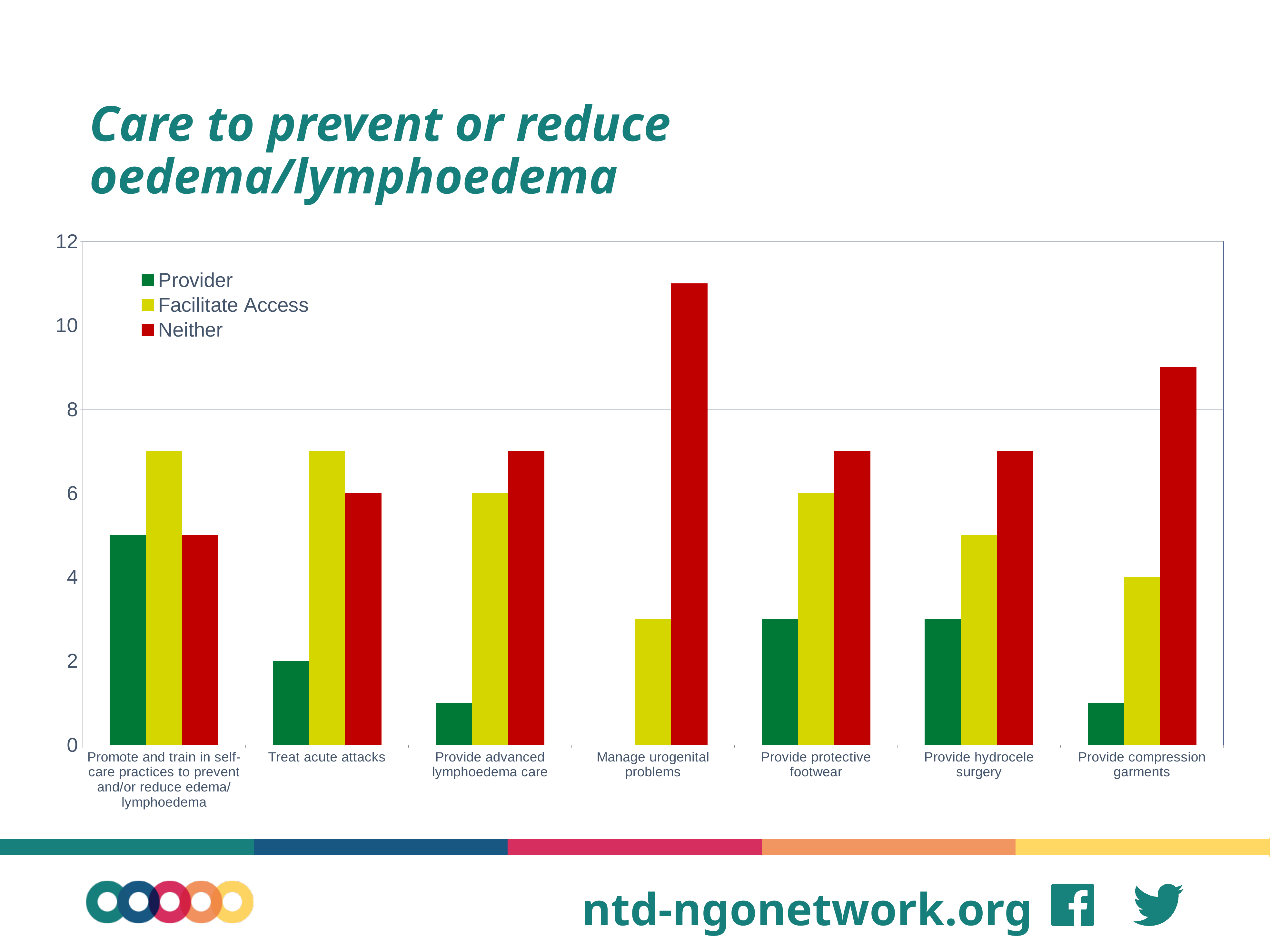
Which category has the highest Provider value? Promote and train in self-care practices to prevent and/or reduce edema/lymphoedema What kind of chart is shown on the slide? bar chart Which category has the highest Neither value? Manage urogenital problems What is the Facilitate Access value for Provide protective footwear? 6 What is the Facilitate Access value for Provide compression garments? 4 Is the Provider value for Provide advanced lymphoedema care greater or less than 2? less How many categories are shown on the x axis? 7 What is the Provider value for Treat acute attacks? 2 Is the Neither value for Manage urogenital problems greater or less than 10? greater What is the Neither value for Treat acute attacks? 6 How many series does the legend list? 3 For Provide hydrocele surgery, which is larger: the Facilitate Access value or the Neither value? Neither